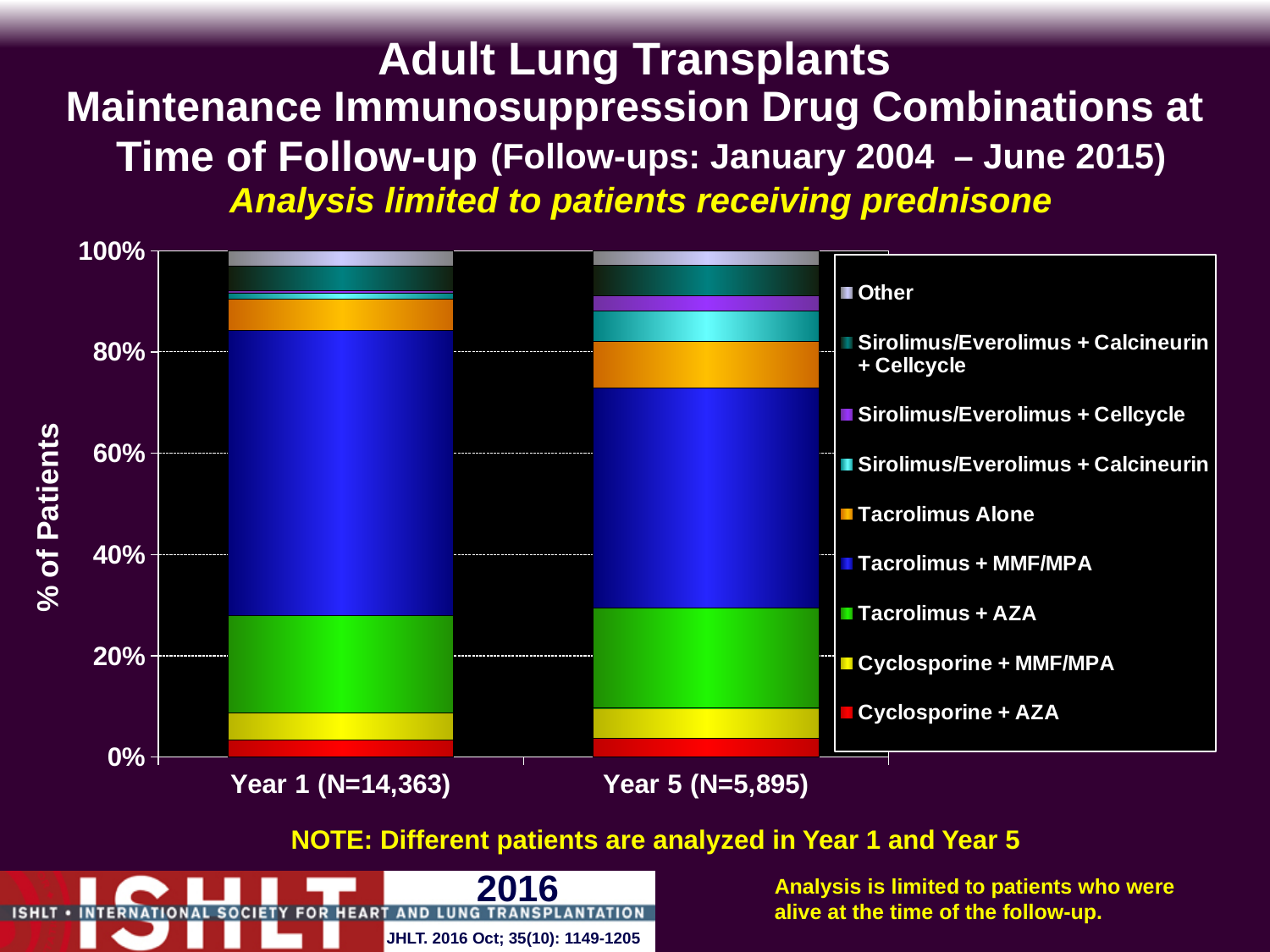
Is the Tacrolimus + MMF/MPA segment larger in Year 1 or in Year 5? Year 1 What is the sample size (N) shown for the Year 1 bar? 14,363 What is the sample size (N) shown for the Year 5 bar? 5,895 In the Year 5 bar, is the top of the Tacrolimus + MMF/MPA segment greater or less than 80%? less What kind of chart is shown on the slide? Stacked bar chart What is the label of the y axis? % of Patients How many series does the legend list? 9 In the Year 1 bar, is the top of the Tacrolimus + MMF/MPA segment greater or less than 80%? greater Is the Tacrolimus Alone segment larger in Year 1 or in Year 5? Year 5 What does each stacked bar total? 100% How many bars (categories) are plotted on the x axis? 2 Which drug combination occupies the largest segment of the Year 1 bar? Tacrolimus + MMF/MPA